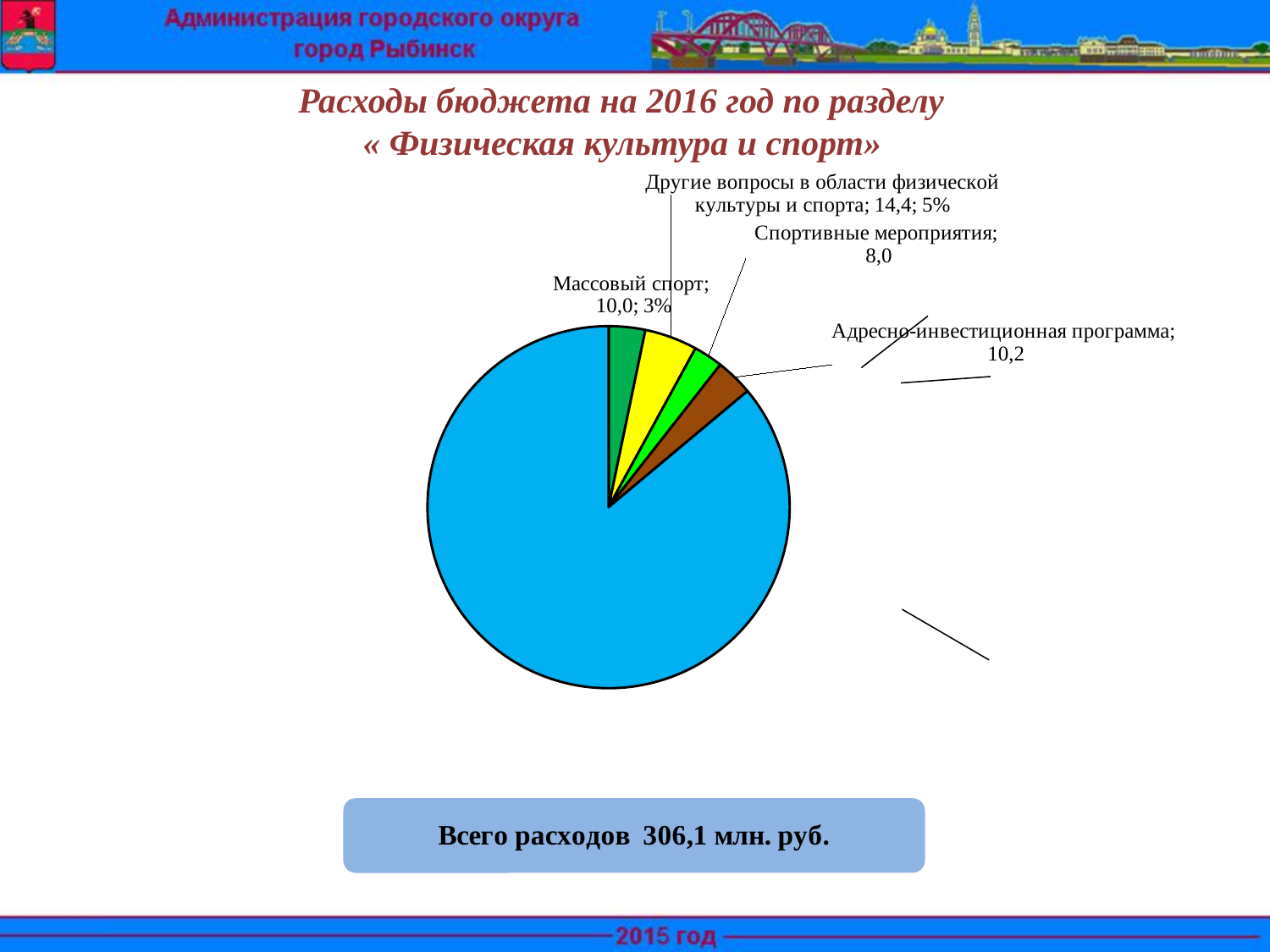
How many slices does the pie chart have? 5 What is the value for «Адресно-инвестиционная программа»? 10,2 What is the value for «Другие вопросы в области физической культуры и спорта»? 14,4 What share of the pie does «Другие вопросы в области физической культуры и спорта» represent? 5% What kind of chart is shown on the slide? pie chart What total expenditure is stated below the chart? 306,1 млн. руб. What share of the pie does «Массовый спорт» represent? 3% What is the value for «Спортивные мероприятия»? 8,0 What is the value for «Массовый спорт»? 10,0 Which is larger, «Другие вопросы в области физической культуры и спорта» or «Спортивные мероприятия»? Другие вопросы в области физической культуры и спорта Which of the labelled slices has the smallest value? Спортивные мероприятия What is the difference between «Другие вопросы в области физической культуры и спорта» and «Спортивные мероприятия»? 6,4